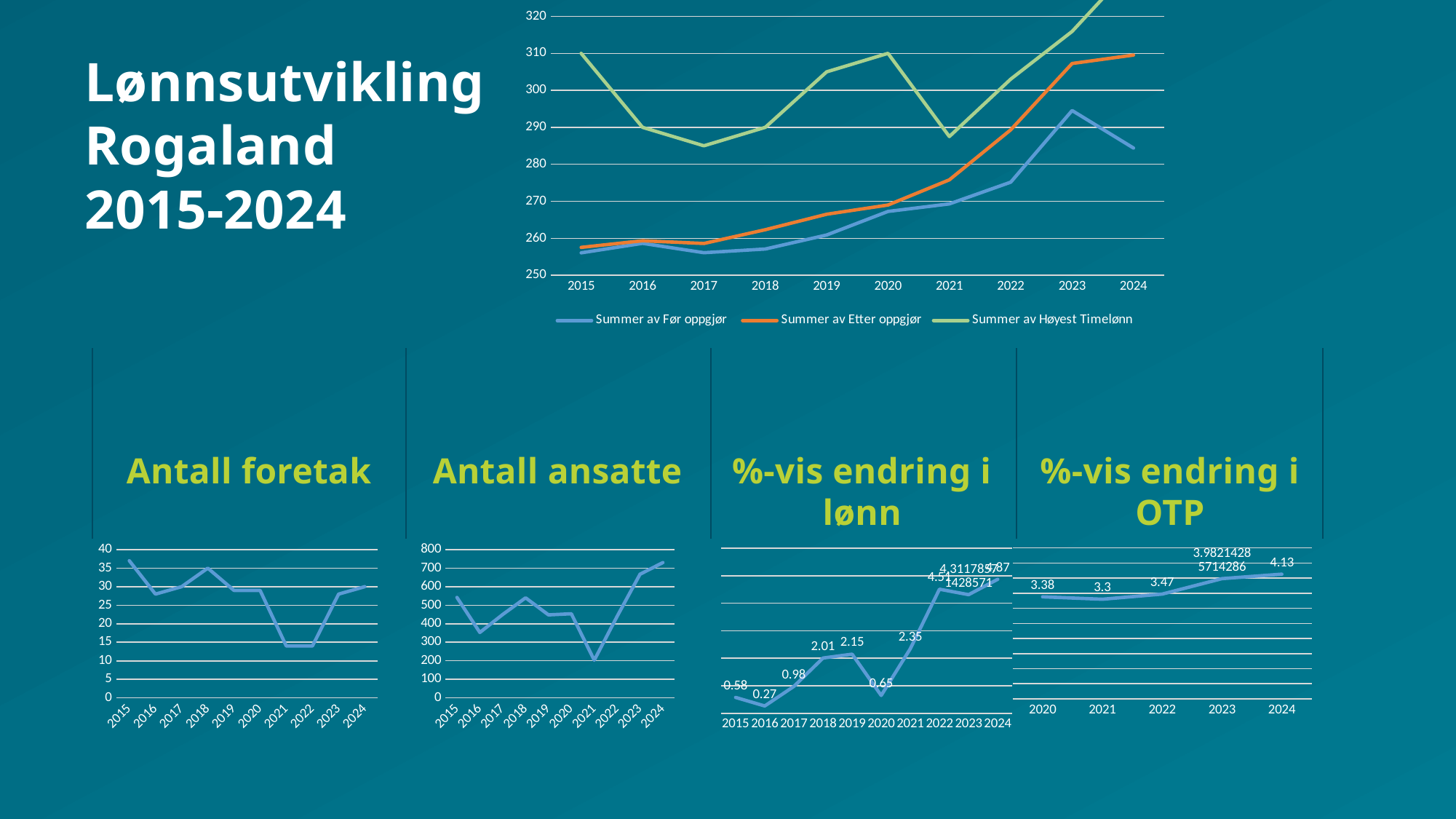
In the top chart, which series has the highest value in 2015? Summer av Høyest Timelønn In the '%-vis endring i OTP' chart, which year has the lowest value? 2021 In the 'Antall ansatte' chart, is the value for 2021 greater or less than 300? less In the 'Antall ansatte' chart, which year has the highest value? 2024 In the '%-vis endring i lønn' chart, what is the value for 2016? 0.27 In the top chart, is the value of Summer av Før oppgjør in 2023 greater or less than 290? greater In the top chart, how many series does the legend list? 3 In the '%-vis endring i lønn' chart, what is the difference between the values for 2019 and 2018? 0.14 What kind of chart is the top chart on the slide? line chart In the 'Antall foretak' chart, is the value for 2021 greater or less than 20? less In the '%-vis endring i OTP' chart, what is the value for 2024? 4.13